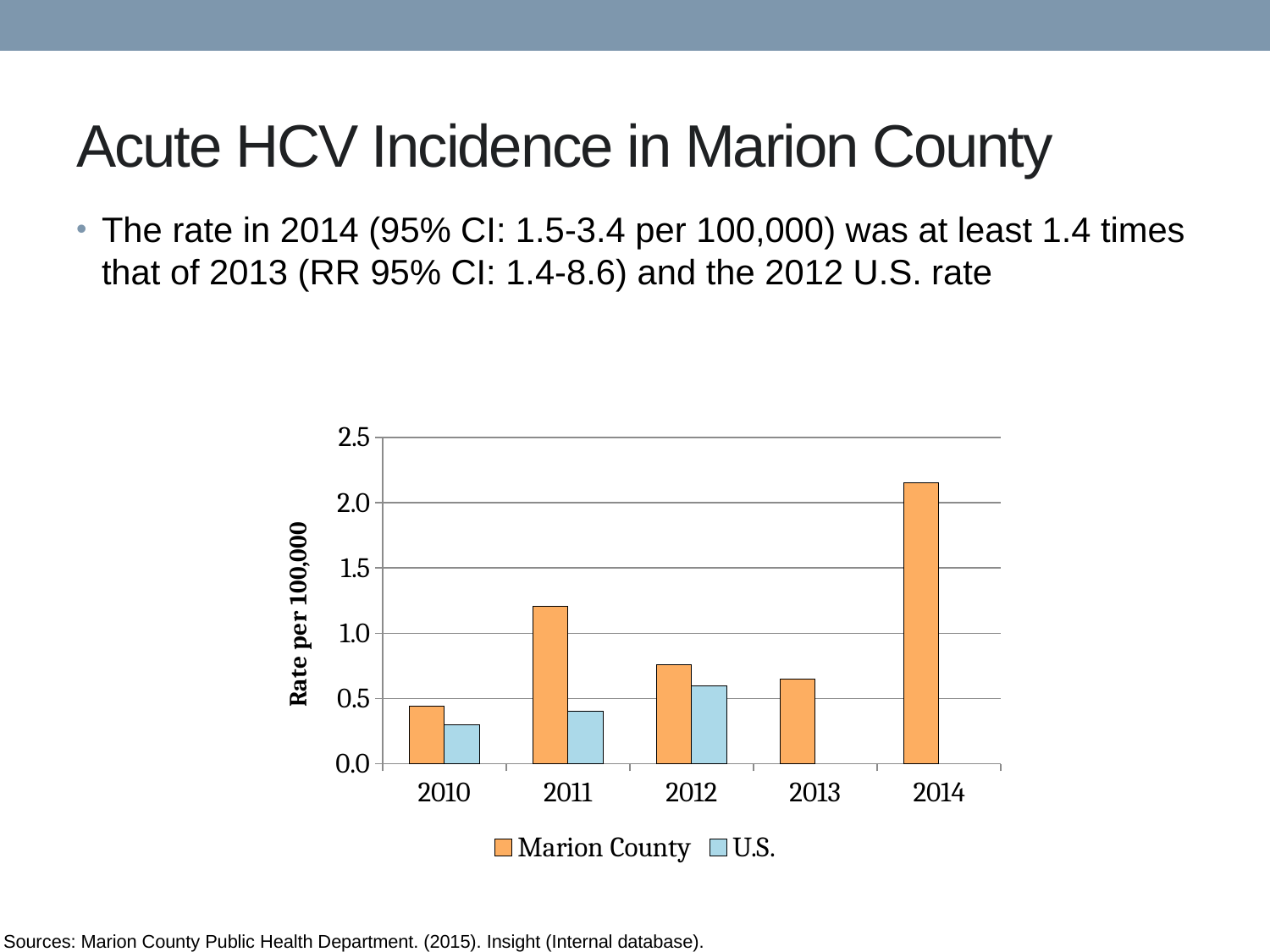
Does the Marion County rate rise or fall from 2011 to 2013? Fall How many years are shown on the x axis? 5 How many series does the legend list? 2 In 2011, which is larger, the Marion County rate or the U.S. rate? Marion County Is the Marion County value for 2011 greater or less than 1.0? greater What kind of chart is shown on the slide? Bar chart Is the Marion County value for 2014 greater or less than 2.0? greater What is the label on the y axis? Rate per 100,000 Is the U.S. value for 2010 greater or less than 0.5? less In which year is the Marion County rate lowest? 2010 In which year is the U.S. rate highest? 2012 In which year is the Marion County rate highest? 2014